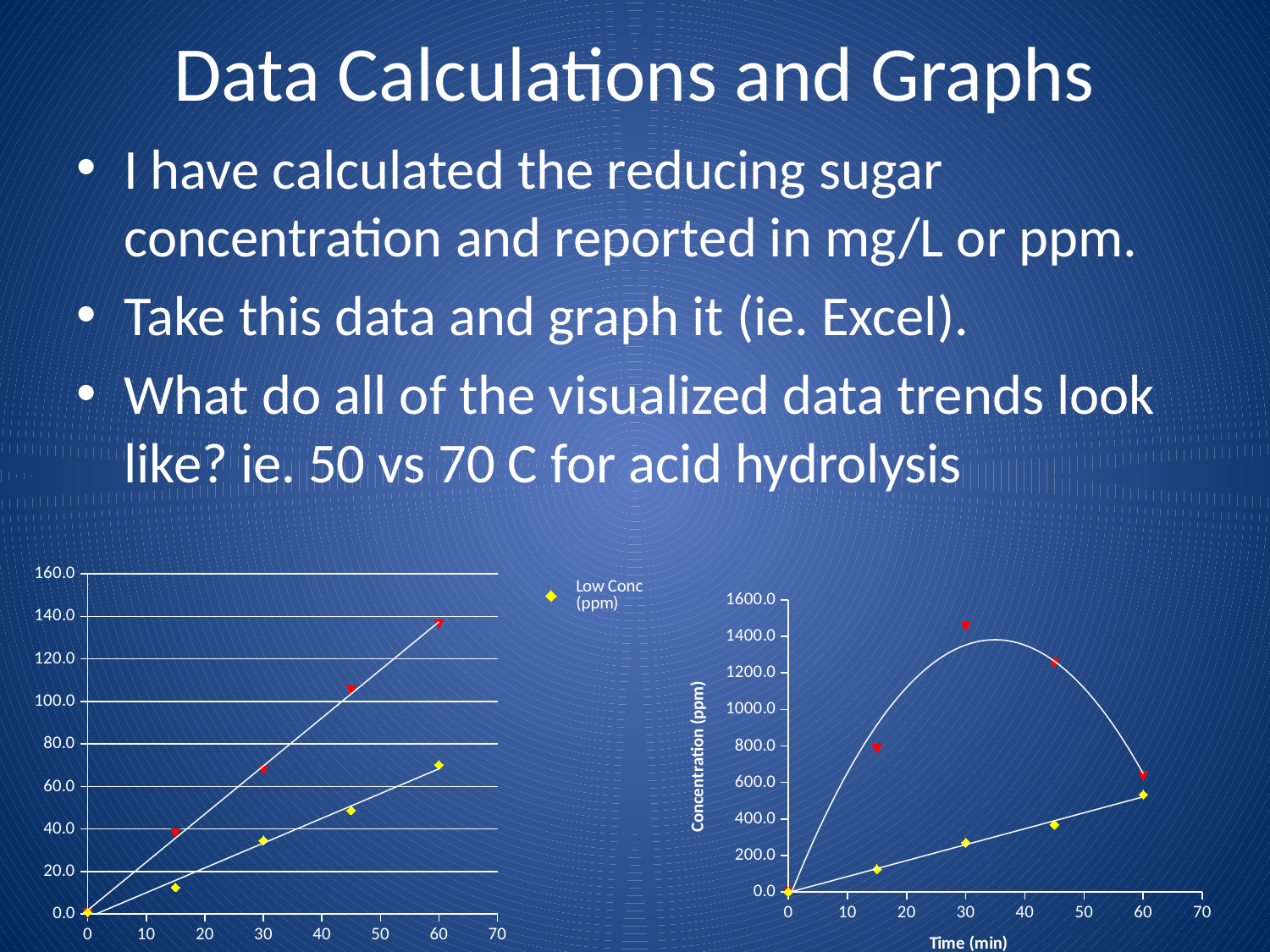
On the left chart, is the red triangle value at 60 on the x axis greater or less than 120? greater On the right chart, at which time in minutes does the red triangle series reach its highest value? 30 On the left chart, is the red triangle value at 30 on the x axis greater or less than 80? less On the right chart, is the yellow diamond value at 60 minutes greater or less than 400? greater On the right chart, what is the title of the x axis? Time (min) On the right chart, do the yellow diamond values rise or fall as time increases? rise On the right chart, what is the title of the y axis? Concentration (ppm) On the left chart, how many yellow diamond data points are plotted? 5 On the left chart, at 60 on the x axis, which series has the larger value, the red triangles or the yellow diamonds? red triangles